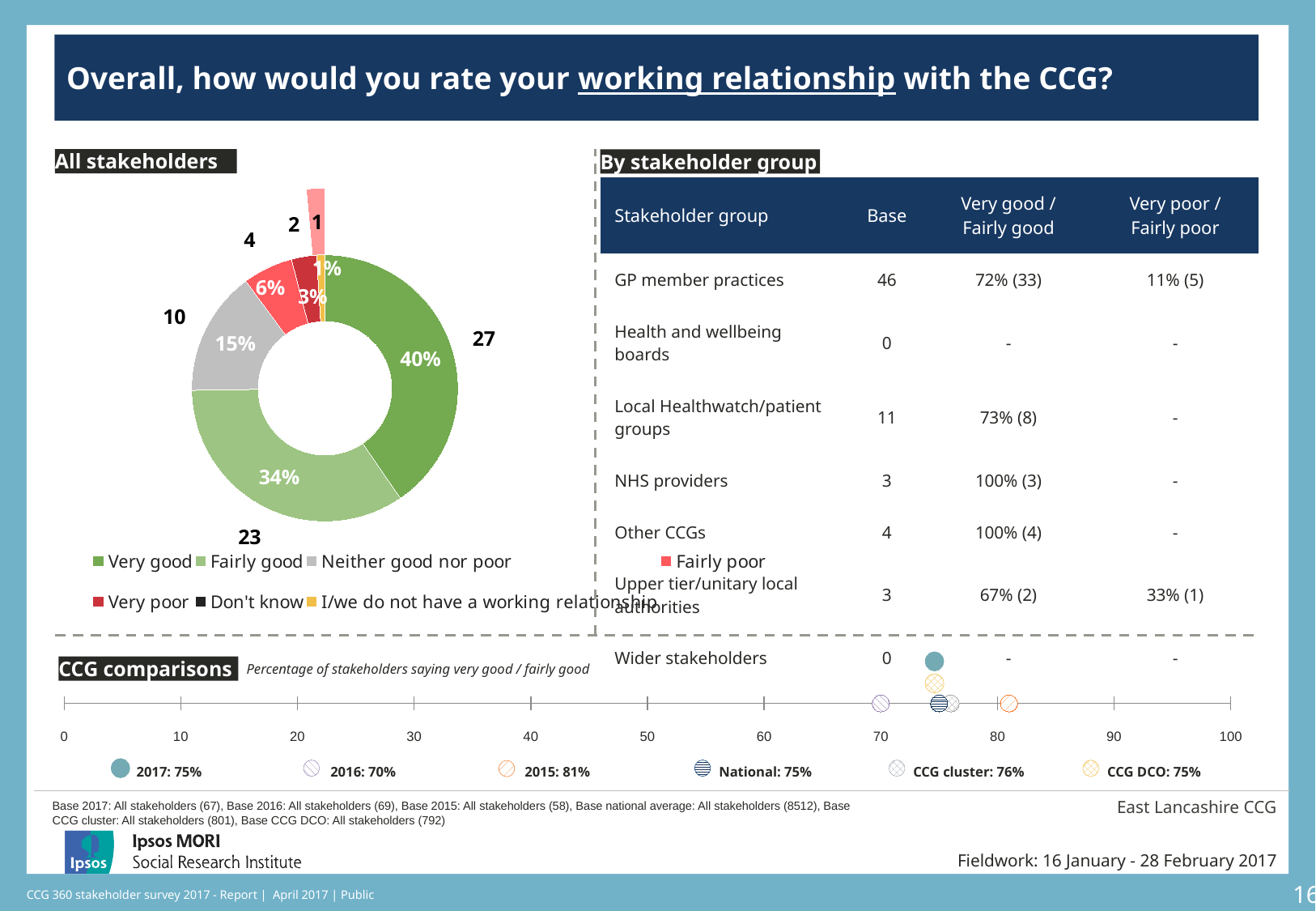
In the 'All stakeholders' donut chart, what percentage of stakeholders rated their working relationship as 'Very good'? 40% In the 'All stakeholders' donut chart, which category has the largest share? Very good In the 'CCG comparisons' chart, what percentage of stakeholders said very good / fairly good in 2017? 75% How many entries does the legend of the 'All stakeholders' donut chart list? 7 In the 'All stakeholders' donut chart, what percentage rated the relationship 'Fairly good'? 34% In the 'All stakeholders' donut chart, which is larger: the share for 'Fairly poor' or the share for 'Very poor'? Fairly poor In the 'CCG comparisons' chart, what is the value for CCG cluster? 76% What type of chart is used for the 'All stakeholders' section? Donut (pie) chart In the 'CCG comparisons' chart, which year had the highest percentage saying very good / fairly good? 2015 In the 'CCG comparisons' chart, what is the difference between the 2017 value and the 2016 value? 5 percentage points In the 'All stakeholders' donut chart, what is the difference in percentage points between 'Very good' and 'Fairly good'? 6 In the 'All stakeholders' donut chart, how many stakeholders answered 'Neither good nor poor'? 10